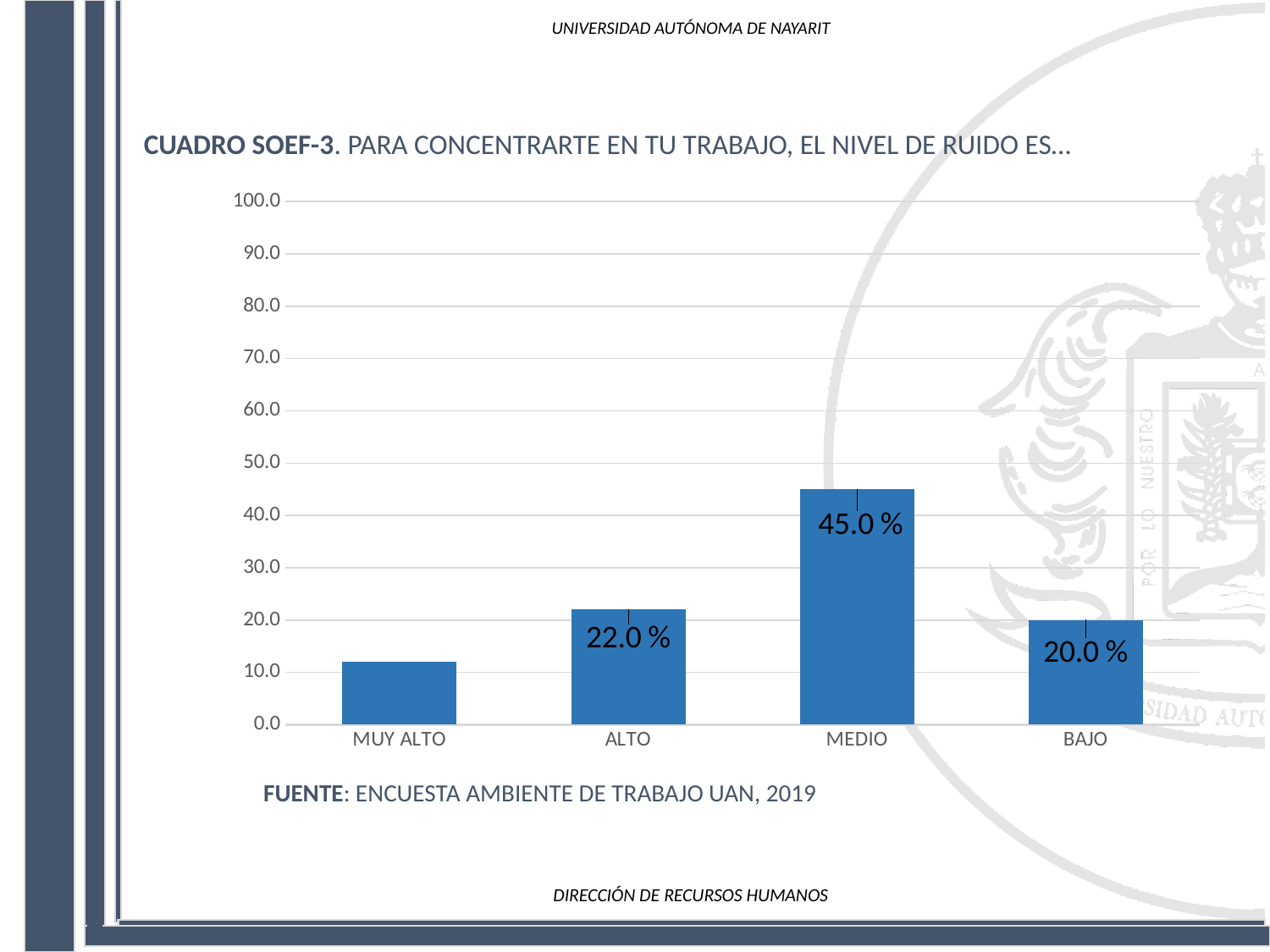
What is the difference between the values for ALTO and BAJO? 2.0 % Is the value for MUY ALTO greater or less than 10.0? greater Which is larger, the value for ALTO or the value for BAJO? ALTO What is the value for MEDIO? 45.0 % What is the difference between the values for MEDIO and ALTO? 23.0 % Is the value for MUY ALTO greater or less than 20.0? less What kind of chart is shown on the slide? Bar chart What is the value for ALTO? 22.0 % Which category has the lowest value? MUY ALTO How many categories are shown on the x axis? 4 What is the value for BAJO? 20.0 % Which category has the highest value? MEDIO